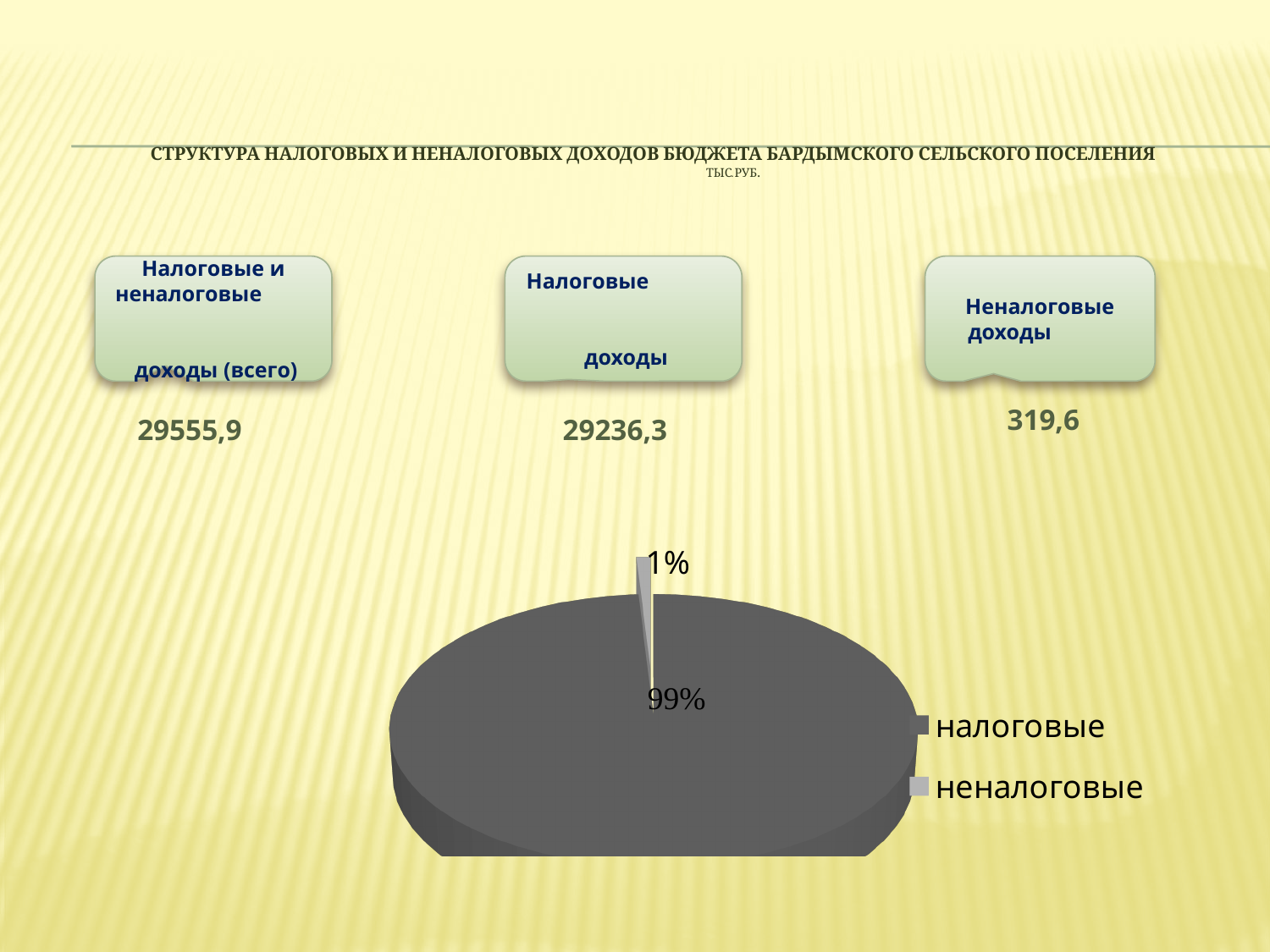
What colour is the налоговые slice in the pie chart? dark grey What share of the pie chart is labelled for неналоговые? 1% What kind of chart is shown on the slide? pie chart Which category has the largest slice in the pie chart? налоговые By how many percentage points does the налоговые share exceed the неналоговые share in the pie chart? 98 percentage points How many entries does the legend of the pie chart list? 2 Which slice is larger in the pie chart, налоговые or неналоговые? налоговые Which category has the smallest slice in the pie chart? неналоговые What share of the pie chart is labelled for налоговые? 99% How many slices does the pie chart have? 2 What are the two legend entries of the pie chart? налоговые, неналоговые